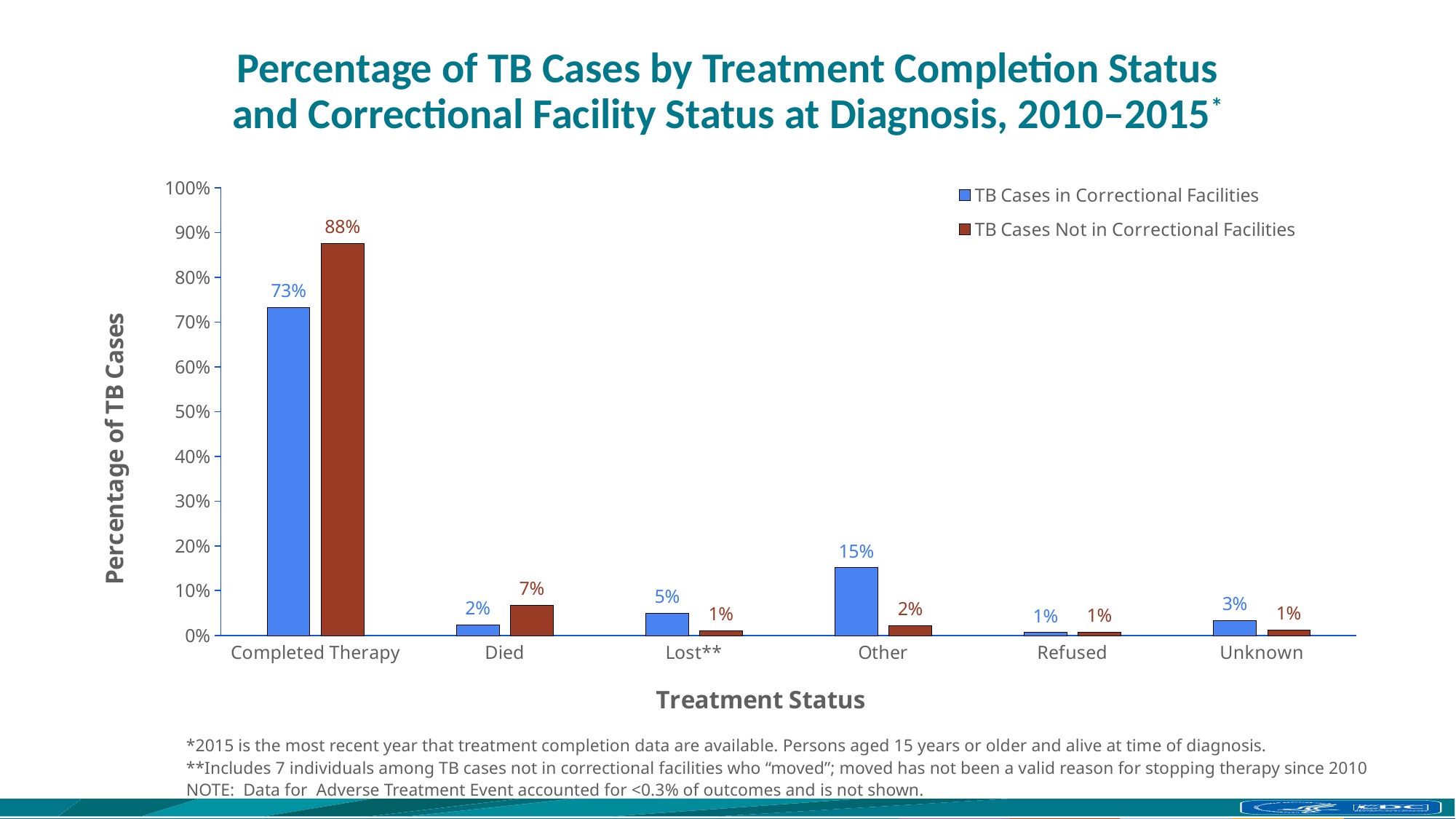
Is the value for TB cases not in correctional facilities in the Completed Therapy category greater or less than 80%? greater What percentage of TB cases not in correctional facilities completed therapy? 88% What percentage of TB cases in correctional facilities completed therapy? 73% Which treatment status has the highest value for TB cases in correctional facilities? Completed Therapy How many series does the legend list? 2 What kind of chart is shown on the slide? Bar chart How many treatment status categories are shown on the x axis? 6 What is the value for TB cases not in correctional facilities in the Died category? 7% What is the label of the y axis? Percentage of TB Cases What is the value for TB cases in correctional facilities in the Other category? 15% For the Lost** category, which series has the larger value: TB cases in correctional facilities or TB cases not in correctional facilities? TB Cases in Correctional Facilities What is the difference between the Completed Therapy values for cases not in correctional facilities and cases in correctional facilities? 15%